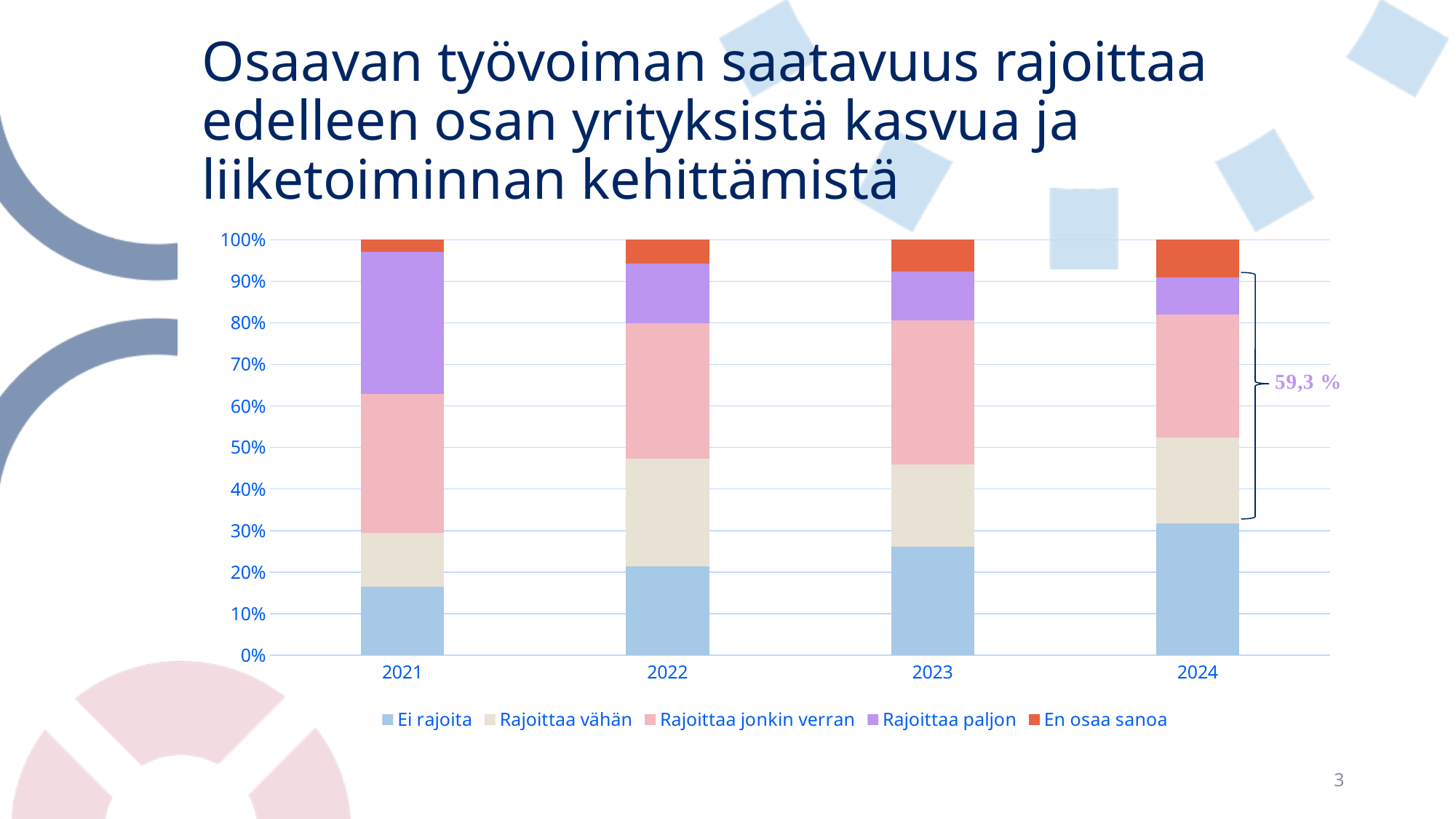
Which year has the smallest 'Ei rajoita' segment? 2021 Is the 'Ei rajoita' share in 2024 greater or less than 30%? greater Is the 'Ei rajoita' share in 2021 greater or less than 20%? less Which year has the largest 'Rajoittaa paljon' segment? 2021 Which year has the largest 'Ei rajoita' segment? 2024 What kind of chart is shown on the slide? Stacked bar chart What percentage is shown by the bracket annotation next to the 2024 bar? 59,3 % Does the 'Ei rajoita' share rise or fall from 2021 to 2024? Rises Which series is listed first in the chart legend? Ei rajoita How many series does the chart legend list? 5 How many years are shown on the x axis of the chart? 4 Which is larger: the 'Rajoittaa paljon' segment in 2021 or in 2024? 2021